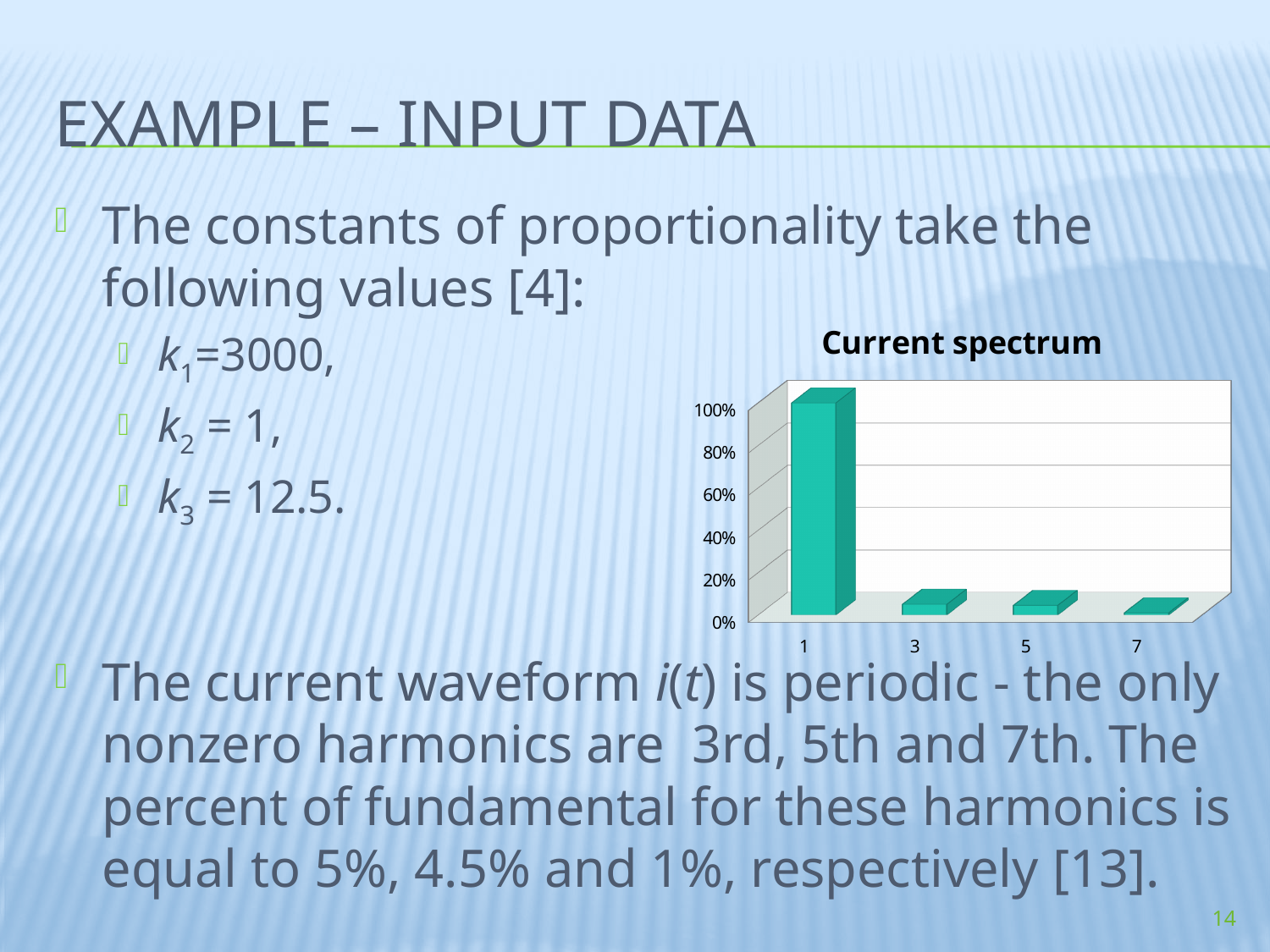
Is the value for category 5 greater or less than 20%? less Which is larger in the Current spectrum chart, the value for category 1 or the value for category 3? 1 What is the title of the chart? Current spectrum What is the value for category 1 in the Current spectrum chart? 100% Which category has the highest value in the Current spectrum chart? 1 Is the value for category 3 greater or less than 20%? less Is the value for category 1 greater or less than 80%? greater Which category has the lowest value in the Current spectrum chart? 7 What kind of chart is shown on the slide? bar chart Do the values in the Current spectrum chart generally rise or fall from left to right along the x axis? fall How many categories are shown on the x axis of the Current spectrum chart? 4